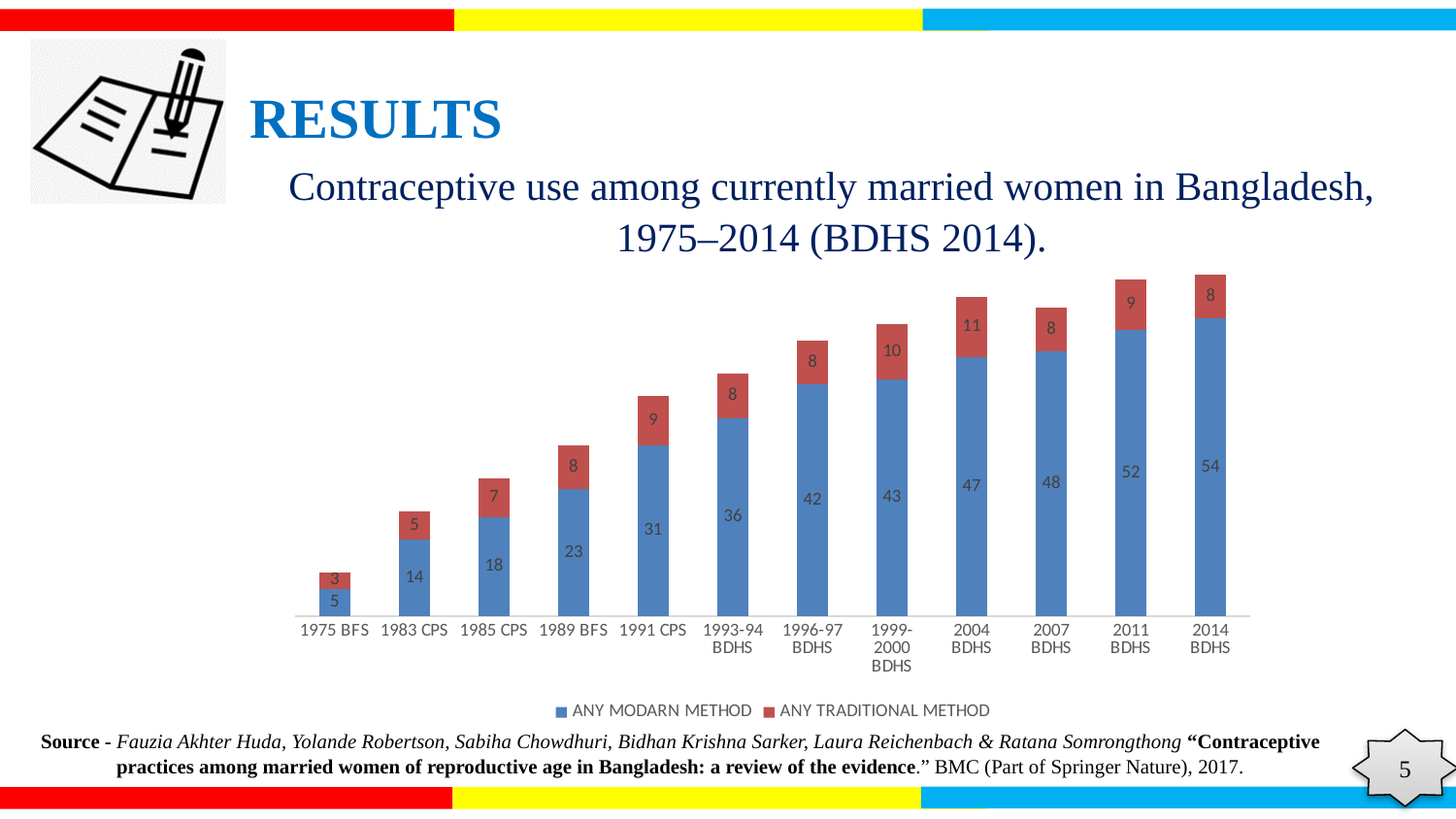
What kind of chart is shown on the slide? Stacked bar chart Which survey has the lowest value for ANY TRADITIONAL METHOD? 1975 BFS Which survey has the highest value for ANY MODARN METHOD? 2014 BDHS How many survey categories are shown along the x axis? 12 Which is larger, the ANY MODARN METHOD value for 1991 CPS or for 1989 BFS? 1991 CPS What is the value for ANY MODARN METHOD in 1975 BFS? 5 What is the total of the stacked bar for 2004 BDHS? 58 How many series does the legend list? 2 What is the difference between the ANY MODARN METHOD values for 2014 BDHS and 1975 BFS? 49 What is the value for ANY TRADITIONAL METHOD in 2004 BDHS? 11 Does the ANY MODARN METHOD value rise or fall from 1975 BFS to 2014 BDHS? Rise What is the value for ANY MODARN METHOD in 2014 BDHS? 54